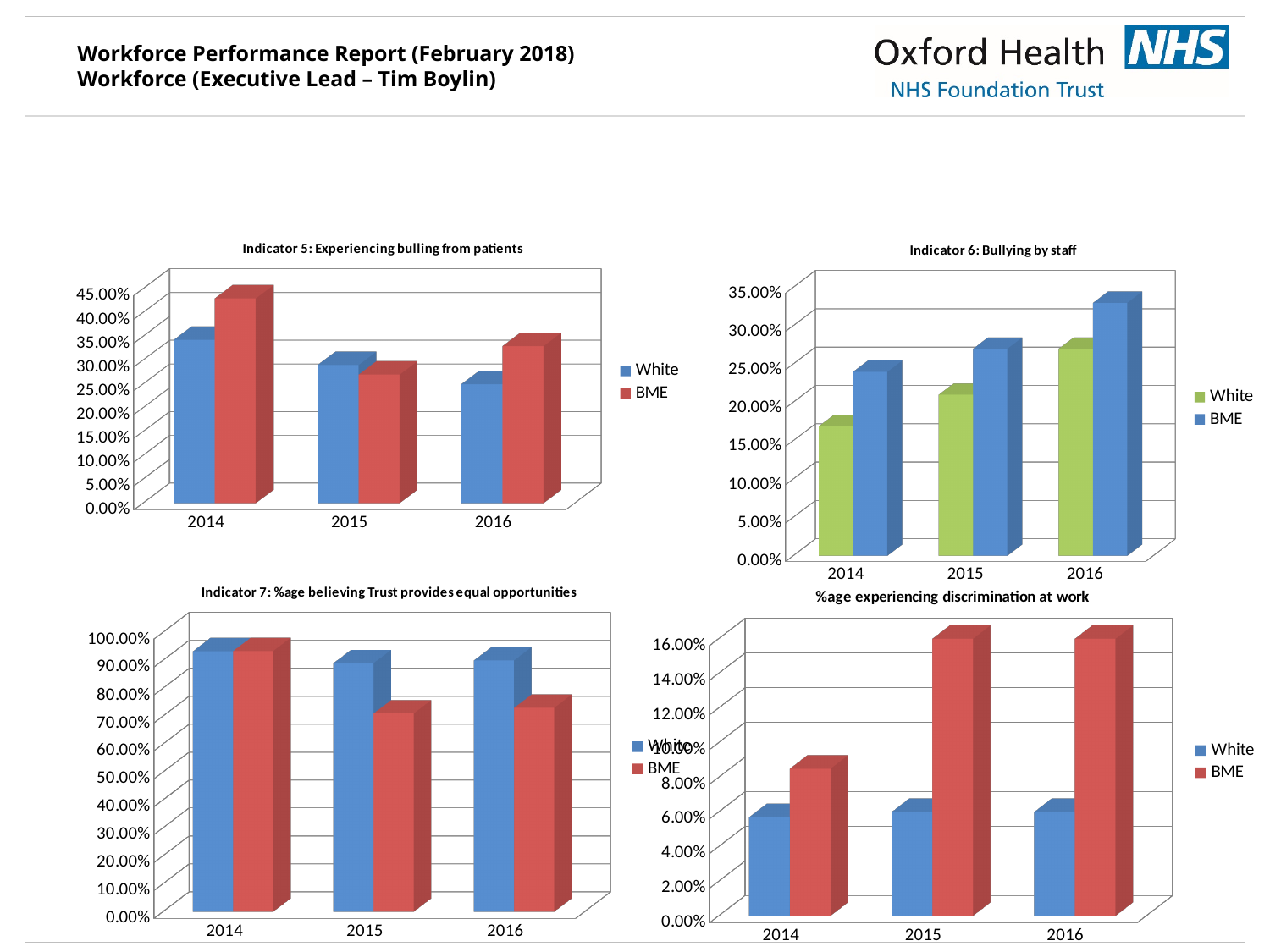
How many years are shown on the x axis of the '%age experiencing discrimination at work' chart? 3 In the '%age experiencing discrimination at work' chart, which year has the lowest BME value? 2014 In the 'Indicator 5: Experiencing bulling from patients' chart, is the value for White in 2014 greater or less than 30.00%? greater In the '%age experiencing discrimination at work' chart, is the value for BME in 2015 greater or less than 14.00%? greater In the 'Indicator 6: Bullying by staff' chart, do the White values rise or fall from 2014 to 2016? rise In the 'Indicator 7: %age believing Trust provides equal opportunities' chart, which is larger in 2015, White or BME? White What kind of chart is 'Indicator 6: Bullying by staff'? bar chart In the 'Indicator 6: Bullying by staff' chart, is the value for White in 2014 greater or less than 20.00%? less In the 'Indicator 6: Bullying by staff' chart, which year has the highest BME value? 2016 In the 'Indicator 5: Experiencing bulling from patients' chart, which is larger in 2014, White or BME? BME